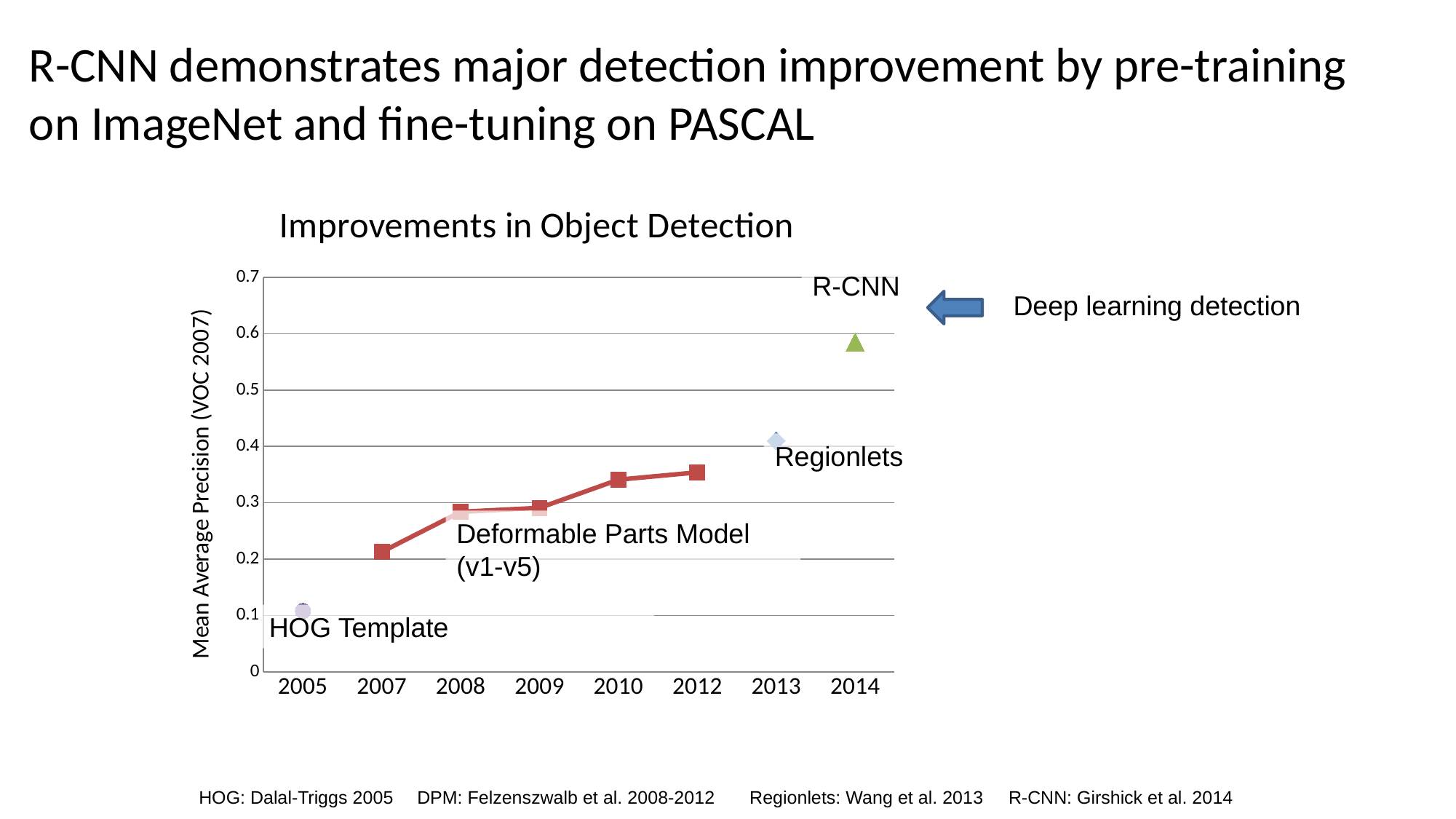
Is the value for the Deformable Parts Model in 2012 greater or less than 0.4? less Is the value for Regionlets in 2013 greater or less than 0.3? greater Which method has the lowest mean average precision on the chart? HOG Template Which has a higher mean average precision, R-CNN or Regionlets? R-CNN Which method has the highest mean average precision on the chart? R-CNN Is the value for R-CNN in 2014 greater or less than 0.5? greater What type of chart is shown on the slide? line chart Do the mean average precision values generally rise or fall from 2005 to 2014? rise What is the title of the chart? Improvements in Object Detection What is the label of the y axis? Mean Average Precision (VOC 2007) How many years are listed along the x axis? 8